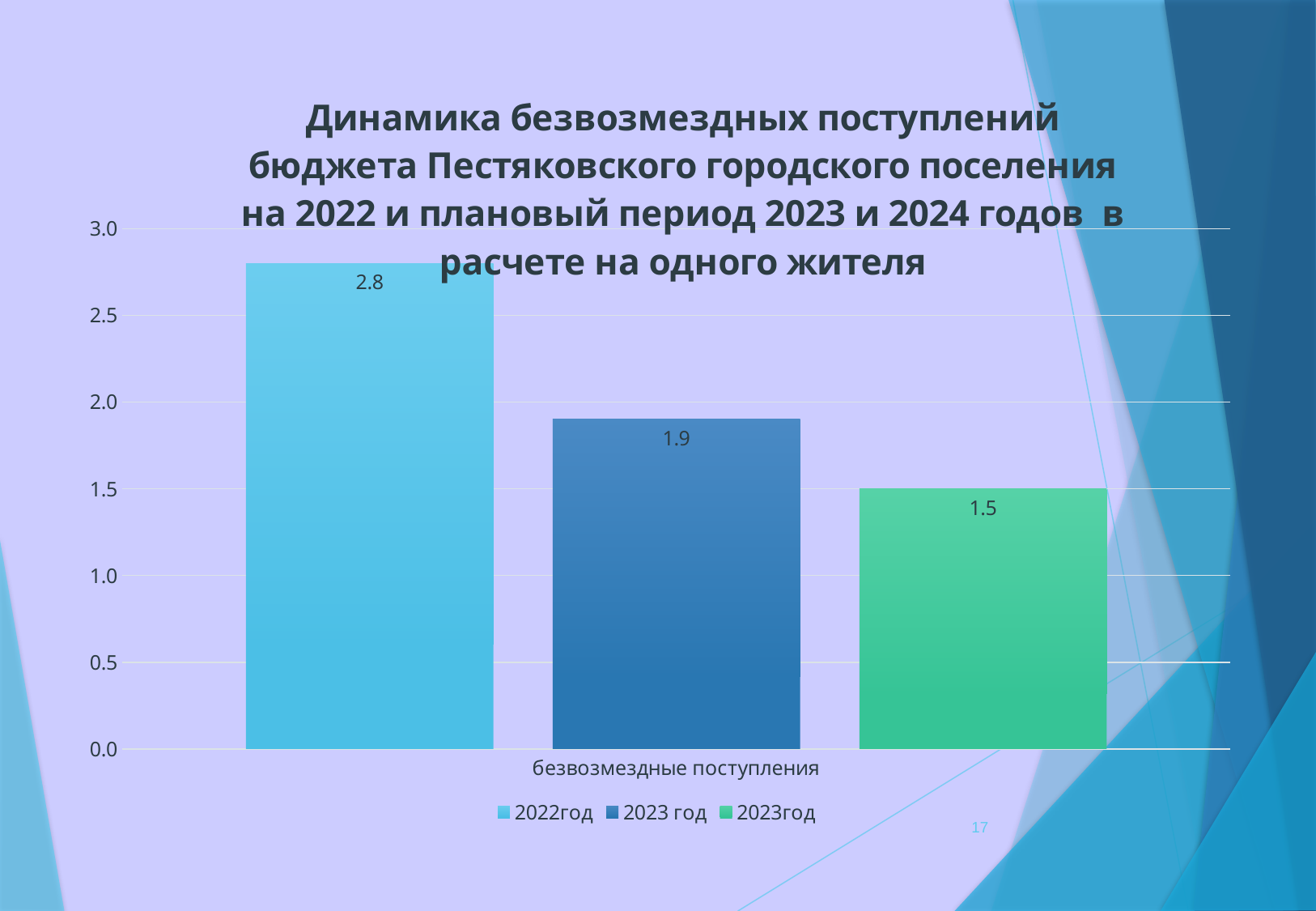
Which series has the highest value? 2022год What is the difference between the left bar (2.8) and the middle bar (1.9)? 0.9 Do the bar values rise or fall from left to right? fall What is the value of the middle (dark blue) bar? 1.9 Which bar has the lowest value? the green bar on the right (2023год) What is the value of the light blue bar for the 2022год series? 2.8 What is the category label shown on the x axis? безвозмездные поступления Which is larger, the middle dark blue bar or the right green bar? the middle dark blue bar What type of chart is shown on the slide? bar chart What is the difference between the 2022год bar and the green bar on the right? 1.3 How many series does the legend list? 3 What is the value of the green bar on the right? 1.5